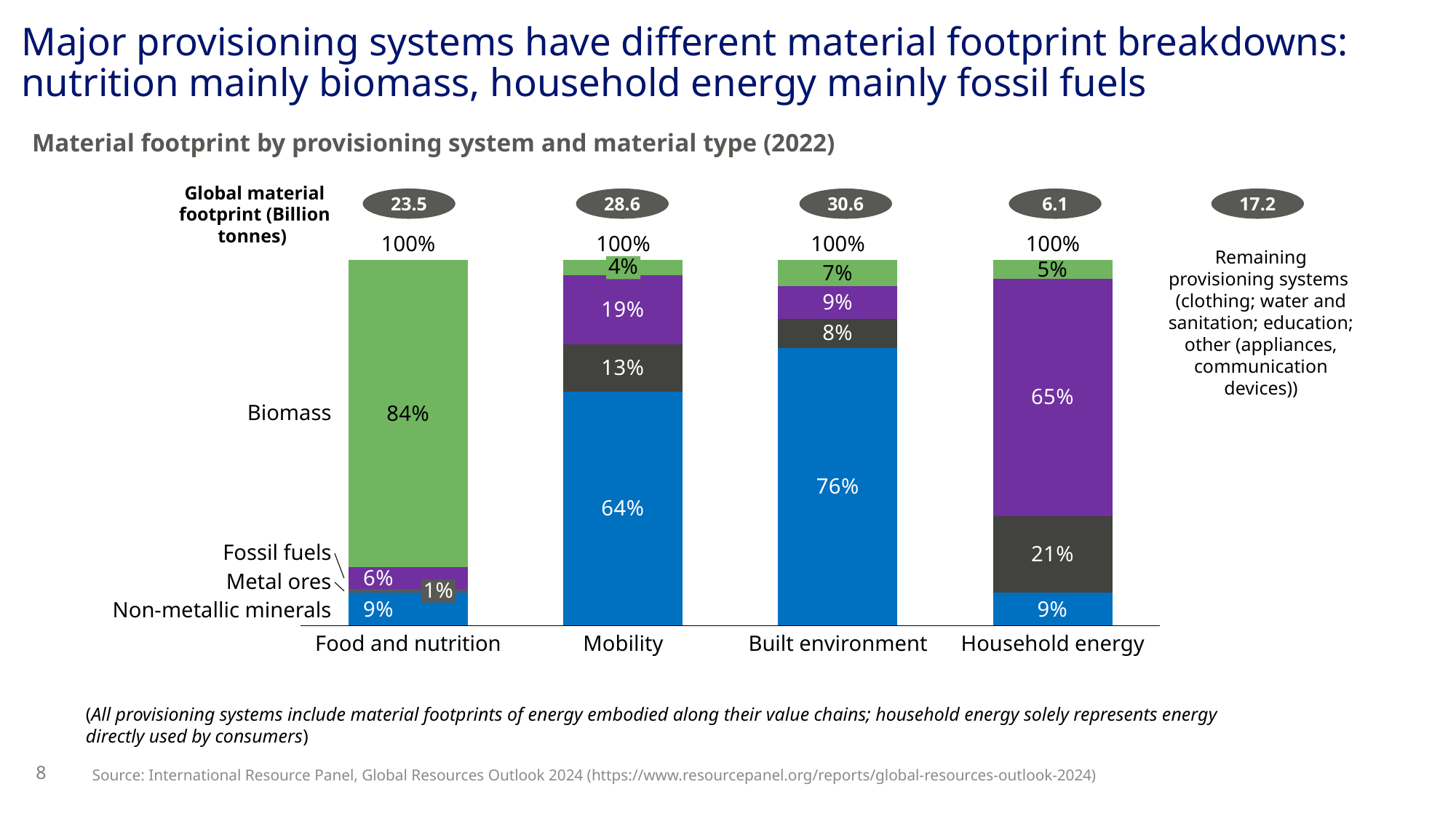
Which is larger: the metal ores share for Household energy or for Mobility? Household energy What share of the Mobility material footprint is non-metallic minerals? 64% What share of the Food and nutrition material footprint is biomass? 84% How many material types are stacked in each bar? 4 Which provisioning system has the smallest global material footprint in billion tonnes? Household energy How many provisioning systems are shown as stacked bars in the chart? 4 Which provisioning system has the largest global material footprint in billion tonnes? Built environment What is the difference between the non-metallic minerals share for Built environment and for Mobility? 12% What type of chart is used to show the material footprint breakdown? Stacked bar chart What share of the Household energy material footprint is fossil fuels? 65% What share of the Built environment material footprint is metal ores? 8% What is the global material footprint in billion tonnes for Built environment? 30.6